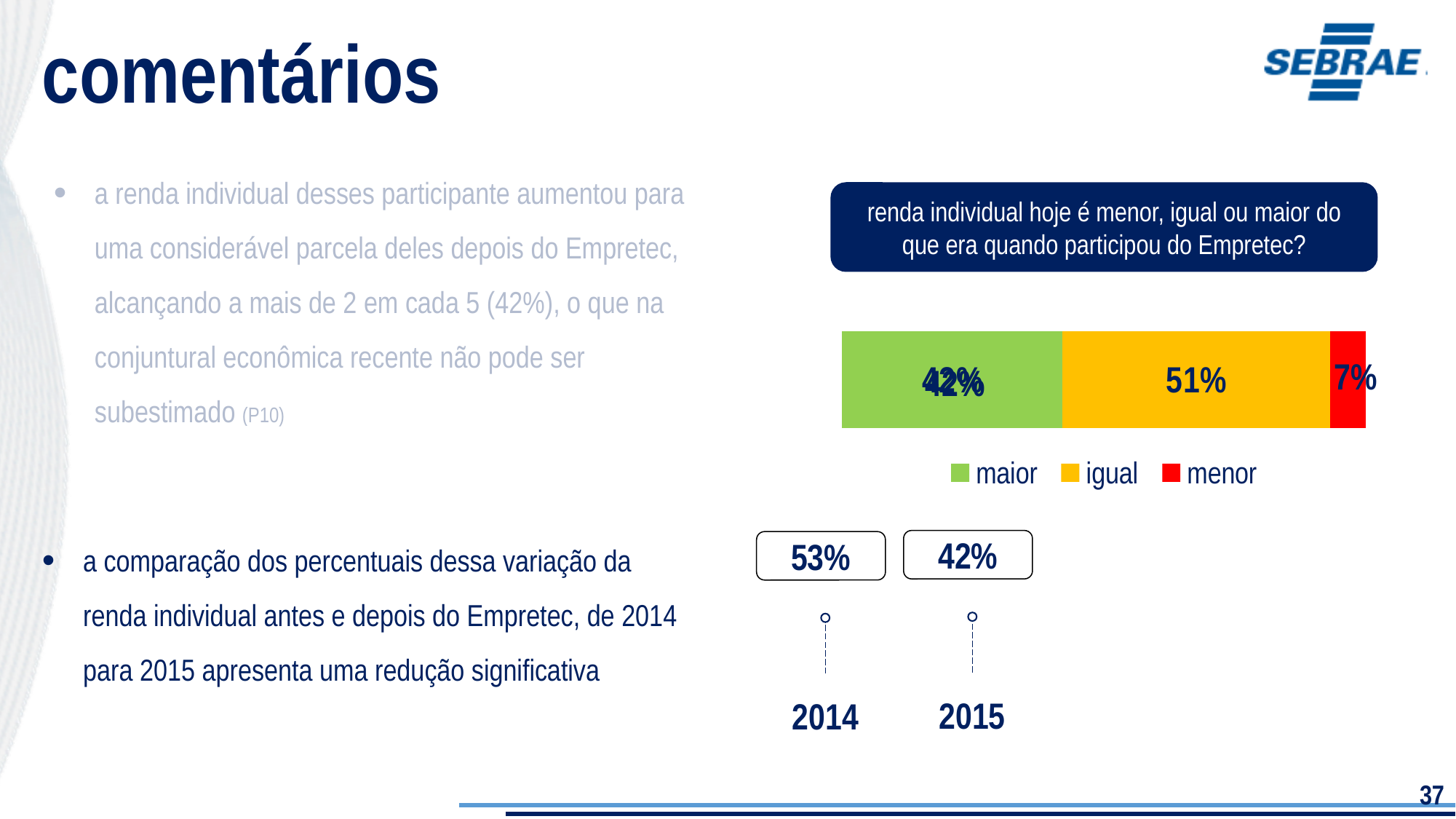
What percentage of respondents answered "maior" in the stacked bar chart? 42% How many series does the legend of the stacked bar chart list? 3 What colour represents "igual" in the stacked bar chart? Yellow What is the total of the three segments in the stacked bar? 100% Which response category has the largest share in the stacked bar chart? igual What kind of chart is used to show the responses about individual income? Stacked bar chart Which is larger in the stacked bar chart, the "maior" share or the "igual" share? igual What percentage of respondents answered "igual" in the stacked bar chart? 51% Which response category has the smallest share in the stacked bar chart? menor What percentage of respondents answered "menor" in the stacked bar chart? 7% How many percentage points larger is the "maior" share than the "menor" share? 35 percentage points How many percentage points larger is the "igual" share than the "menor" share? 44 percentage points